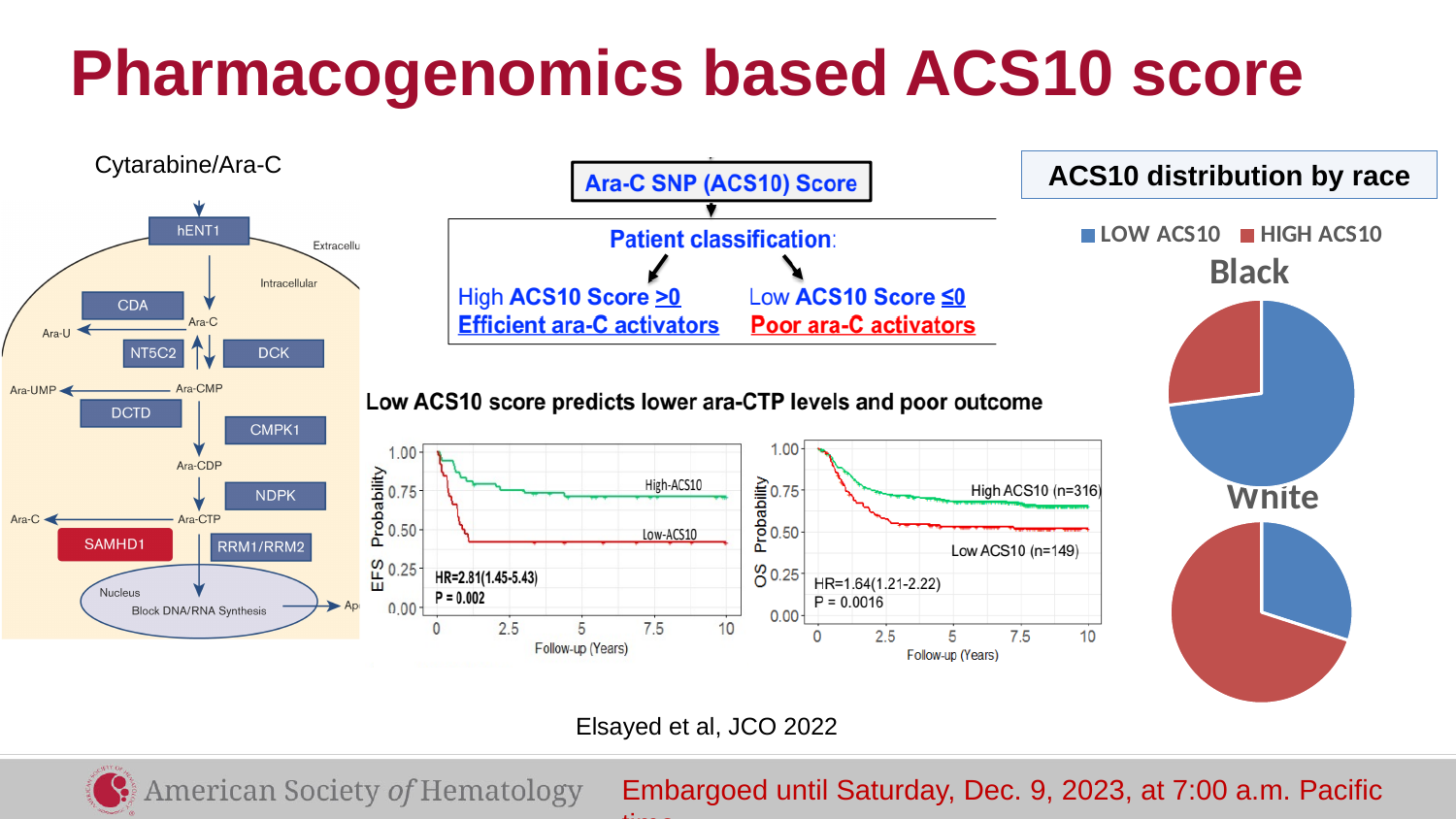
In the White pie chart, which slice is larger, LOW ACS10 or HIGH ACS10? HIGH ACS10 In the Black pie chart, which slice is larger, LOW ACS10 or HIGH ACS10? LOW ACS10 In the 'ACS10 distribution by race' section, which colour represents HIGH ACS10? Red In the 'ACS10 distribution by race' section, how many entries does the legend list? 2 In the 'ACS10 distribution by race' section, what kind of charts are the Black and White charts? Pie charts In the EFS Probability chart, what is the hazard ratio shown? HR=2.81(1.45-5.43) In the OS Probability chart, how many patients are in the High ACS10 group? n=316 In the EFS Probability chart, is the Low-ACS10 curve at 10 years of follow-up greater or less than 0.50? less In the 'ACS10 distribution by race' section, what are the two legend entries? LOW ACS10 and HIGH ACS10 In the OS Probability chart, what is the P value shown? P = 0.0016 In the EFS Probability chart, which curve is higher at 10 years of follow-up, High-ACS10 or Low-ACS10? High-ACS10 In the OS Probability chart, how many patients are in the Low ACS10 group? n=149